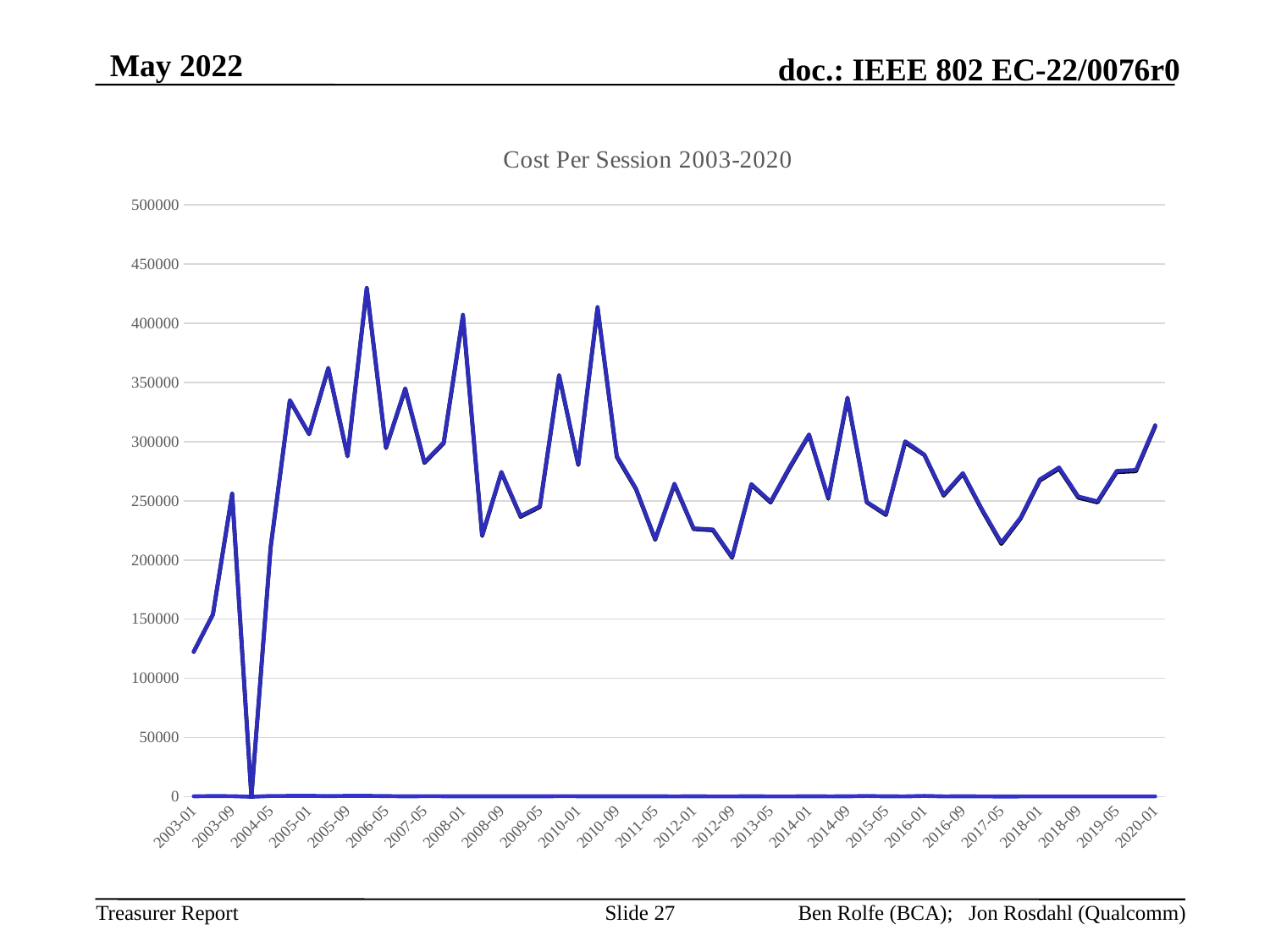
How many labels are shown on the x axis? 26 Is the value for 2017-05 greater or less than 250000? less What kind of chart is shown on the slide? line chart What is the highest tick value shown on the y axis? 500000 Is the lowest value on the chart greater or less than 50000? less Is the value for 2003-09 greater or less than 200000? greater Which is larger, the value for 2003-01 or the value for 2020-01? 2020-01 What is the title of the chart? Cost Per Session 2003-2020